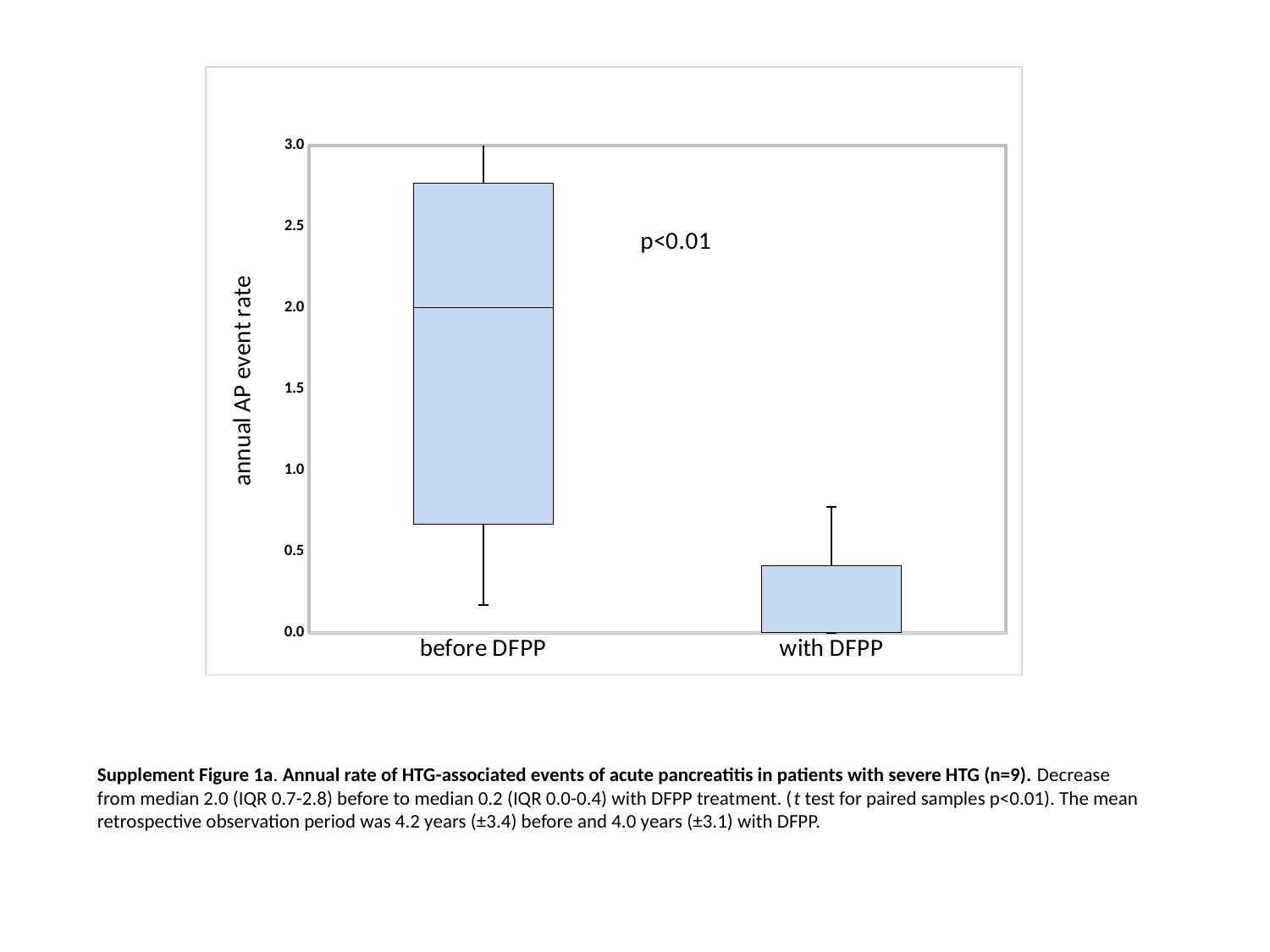
What is the median annual AP event rate before DFPP? 2.0 Is the bottom of the lower whisker for before DFPP greater or less than 0.5? less Is the top of the upper whisker for with DFPP greater or less than 0.5? greater What p-value is annotated on the chart? p<0.01 What is the label of the y axis? annual AP event rate Does the annual AP event rate rise or fall from before DFPP to with DFPP? fall According to the caption, what is the median annual AP event rate with DFPP? 0.2 Is the top of the box for before DFPP greater or less than 2.5? greater How many categories are shown on the x axis? 2 Which category has the higher median annual AP event rate, before DFPP or with DFPP? before DFPP What kind of chart is shown on the slide? box plot